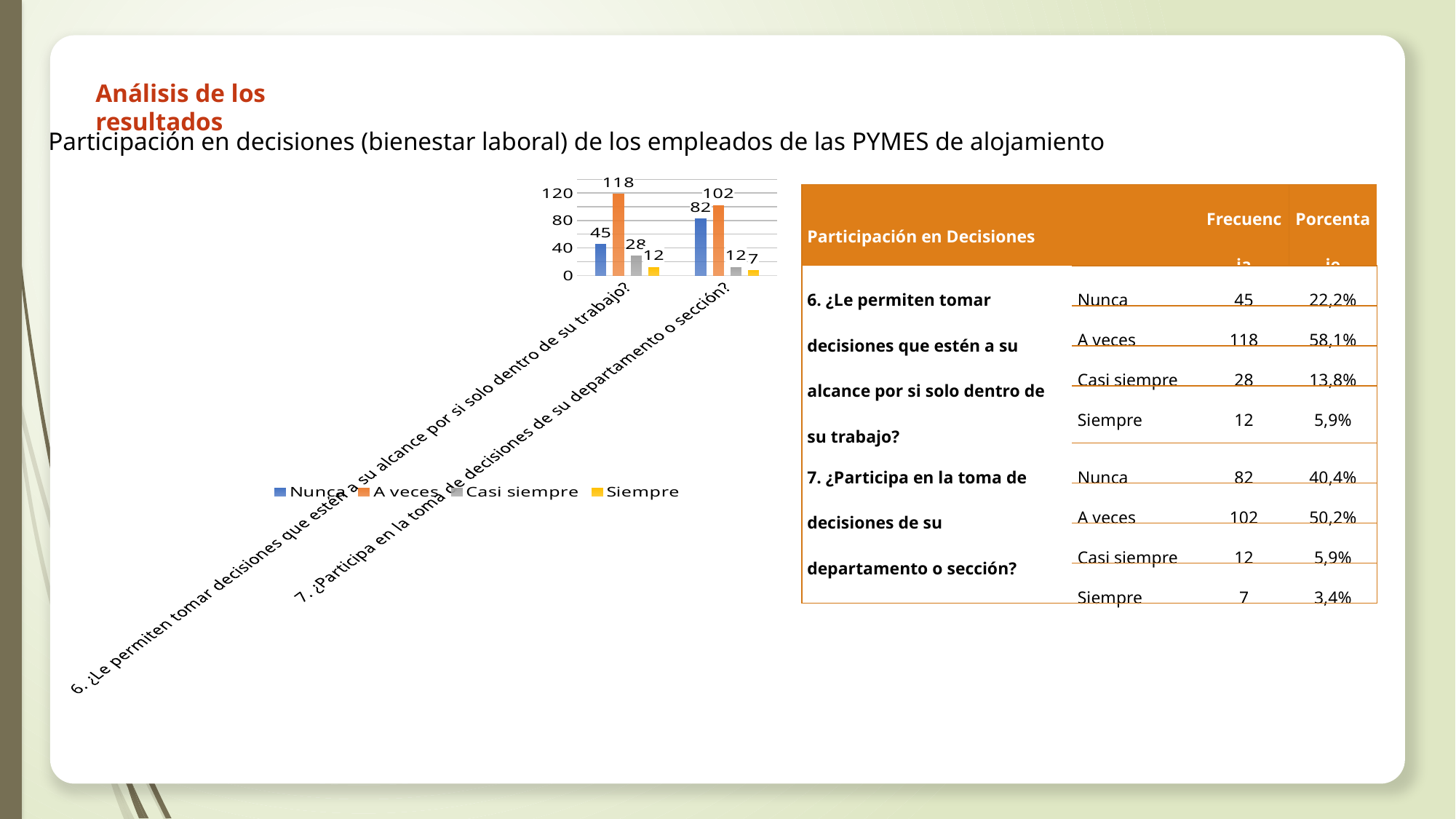
How many categories (questions) are plotted on the x axis of the chart? 2 What kind of chart is shown on the slide? bar chart How many series does the chart legend list? 4 Is the "A veces" value for question 7 greater or less than 80? greater Which series has the lowest value for question 7 (¿Participa en la toma de decisiones de su departamento o sección?)? Siempre Which colour represents the "A veces" series in the chart legend? orange What is the difference between the "A veces" value and the "Nunca" value for question 6? 73 Which series has the highest value for question 6 (¿Le permiten tomar decisiones que estén a su alcance por si solo dentro de su trabajo?)? A veces What is the value of "A veces" for question 6 (¿Le permiten tomar decisiones que estén a su alcance por si solo dentro de su trabajo?)? 118 What is the value of "Siempre" for question 7 (¿Participa en la toma de decisiones de su departamento o sección?)? 7 Which is larger: the "Nunca" value for question 6 or the "Nunca" value for question 7? question 7 What is the value of "Nunca" for question 7 (¿Participa en la toma de decisiones de su departamento o sección?)? 82